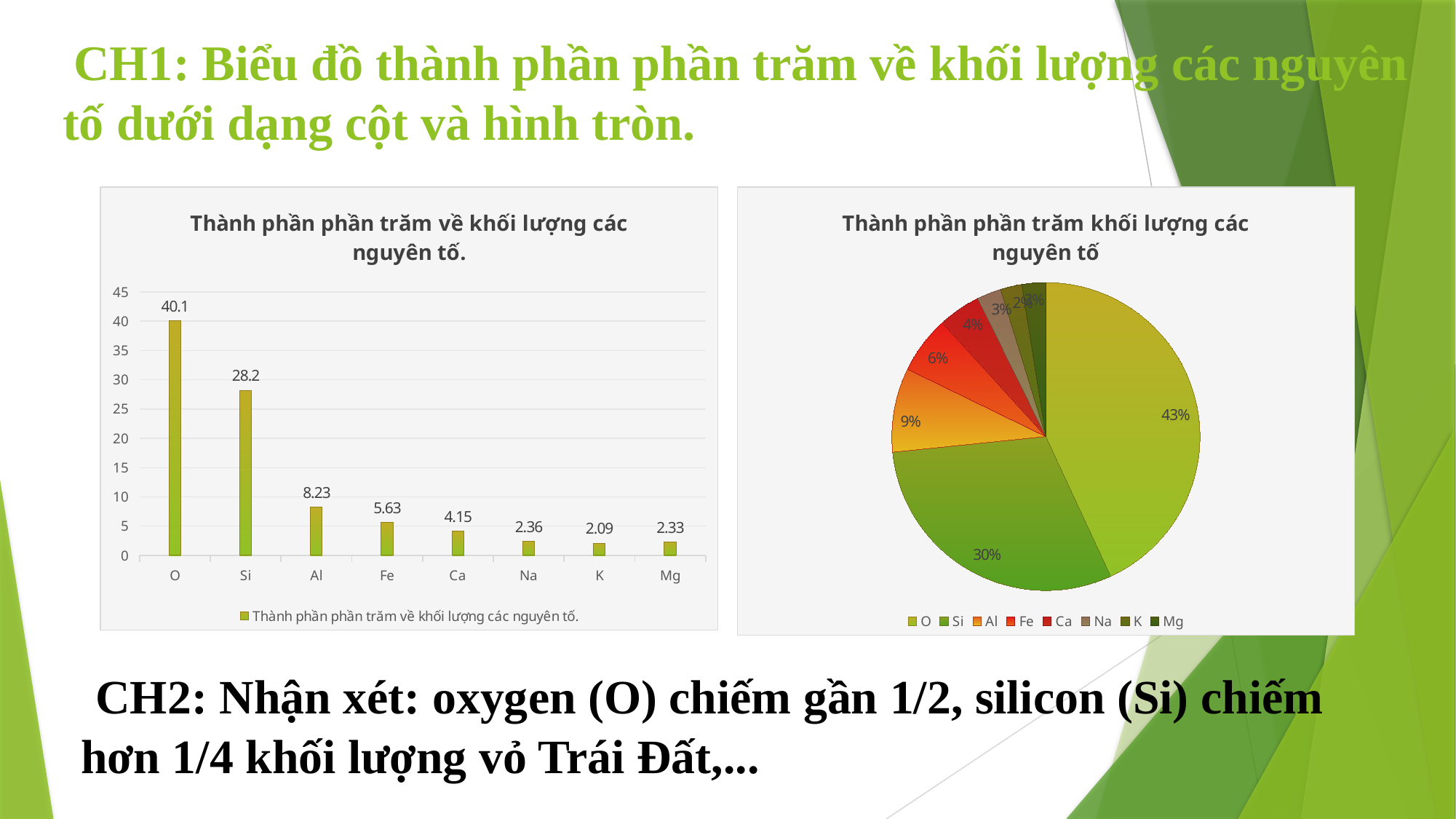
In the bar chart on the left, which is larger, the value for Fe or the value for Ca? Fe How many entries does the legend of the pie chart on the right list? 8 In the bar chart on the left, what is the value for Al? 8.23 In the bar chart on the left, which element has the highest value? O In the bar chart on the left, what is the value for Ca? 4.15 In the bar chart on the left, what is the value for O? 40.1 In the bar chart on the left, what is the difference between the values for O and Si? 11.9 What kind of chart is the chart on the left? bar chart In the pie chart on the right, what share does Si have? 30% In the bar chart on the left, which element has the lowest value? K In the pie chart on the right, what share does O have? 43% How many elements are shown on the x axis of the bar chart on the left? 8